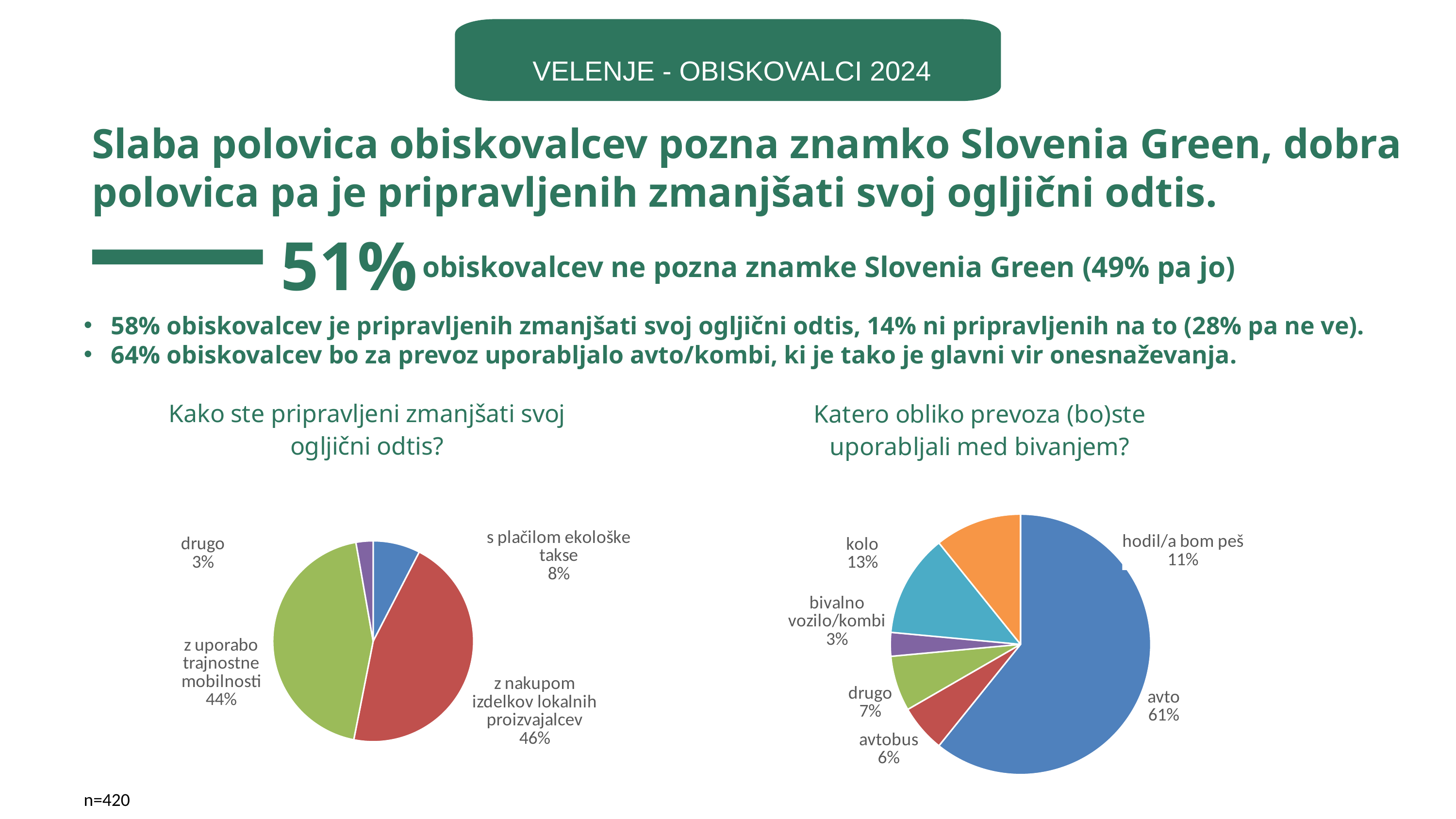
In the chart titled "Katero obliko prevoza (bo)ste uporabljali med bivanjem?", which is larger, the share for "kolo" or the share for "hodil/a bom peš"? kolo In the chart titled "Kako ste pripravljeni zmanjšati svoj ogljični odtis?", what share is labelled for "z nakupom izdelkov lokalnih proizvajalcev"? 46% In the chart titled "Katero obliko prevoza (bo)ste uporabljali med bivanjem?", what share is labelled for "avto"? 61% In the chart titled "Katero obliko prevoza (bo)ste uporabljali med bivanjem?", which category has the largest share? avto In the chart titled "Kako ste pripravljeni zmanjšati svoj ogljični odtis?", which category has the smallest share? drugo In the chart titled "Kako ste pripravljeni zmanjšati svoj ogljični odtis?", how many slices does the pie have? 4 What kind of chart is the one titled "Kako ste pripravljeni zmanjšati svoj ogljični odtis?"? pie chart In the chart titled "Katero obliko prevoza (bo)ste uporabljali med bivanjem?", what is the difference between the shares for "drugo" and "avtobus"? 1% In the chart titled "Katero obliko prevoza (bo)ste uporabljali med bivanjem?", what share is labelled for "kolo"? 13% In the chart titled "Katero obliko prevoza (bo)ste uporabljali med bivanjem?", what colour is the "avto" slice? blue In the chart titled "Kako ste pripravljeni zmanjšati svoj ogljični odtis?", what is the difference between the shares for "z nakupom izdelkov lokalnih proizvajalcev" and "z uporabo trajnostne mobilnosti"? 2% In the chart titled "Katero obliko prevoza (bo)ste uporabljali med bivanjem?", how many categories are shown? 6